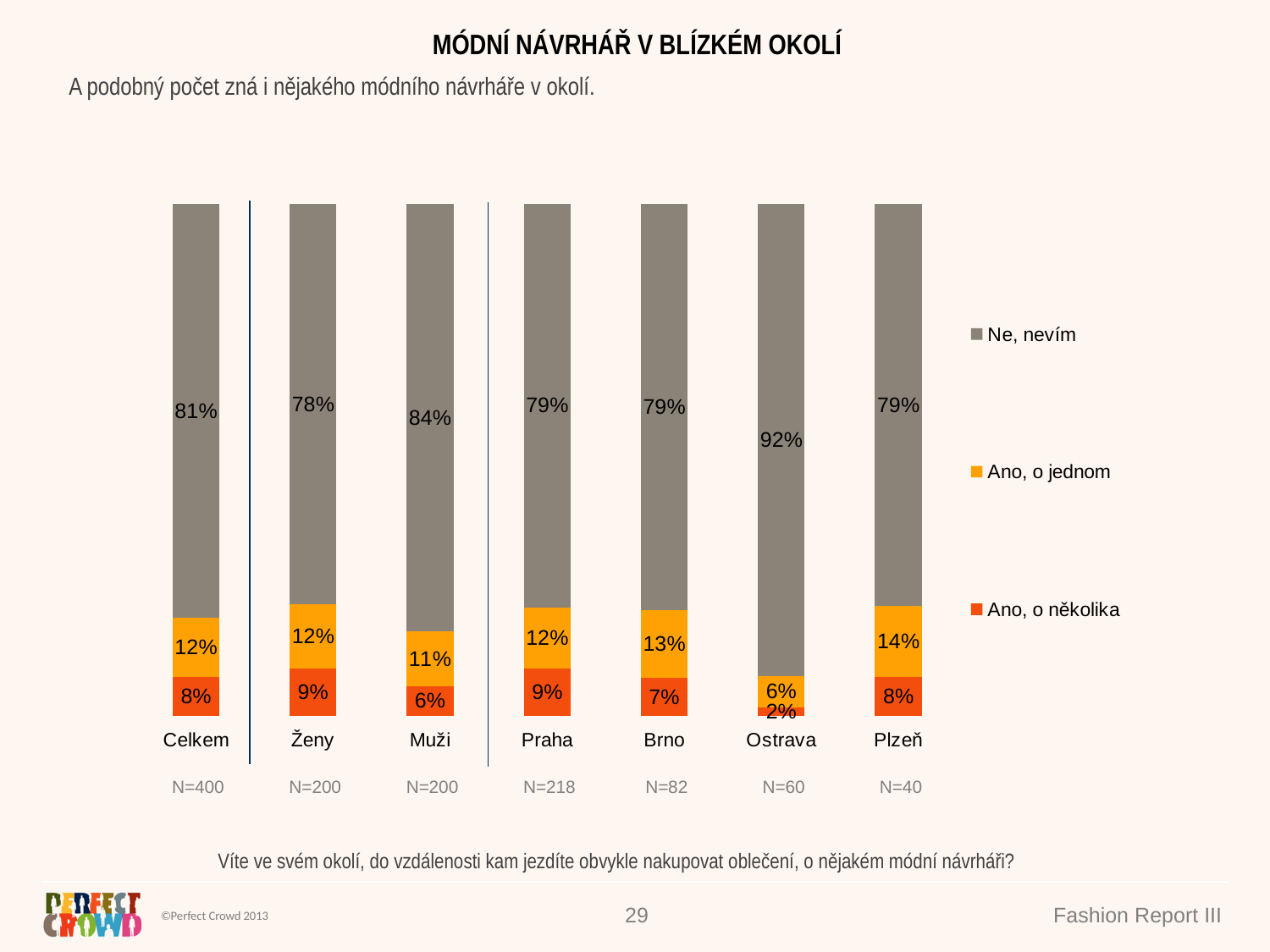
What is the value of "Ano, o několika" for Ženy? 9% What kind of chart is shown on the slide? stacked bar chart How many series does the legend list? 3 Which category has the highest value for "Ne, nevím"? Ostrava Which category has the lowest value for "Ano, o několika"? Ostrava What is the total of the "Ano, o jednom" and "Ano, o několika" segments for Celkem? 20% How many categories are shown along the x axis? 7 What is the value of "Ano, o jednom" for Plzeň? 14% What is the difference between the "Ne, nevím" values for Muži and Ženy? 6% What is the value of "Ne, nevím" for Ostrava? 92% Which is larger, the "Ano, o jednom" value for Brno or for Muži? Brno What is the sample size (N) shown for Praha? N=218